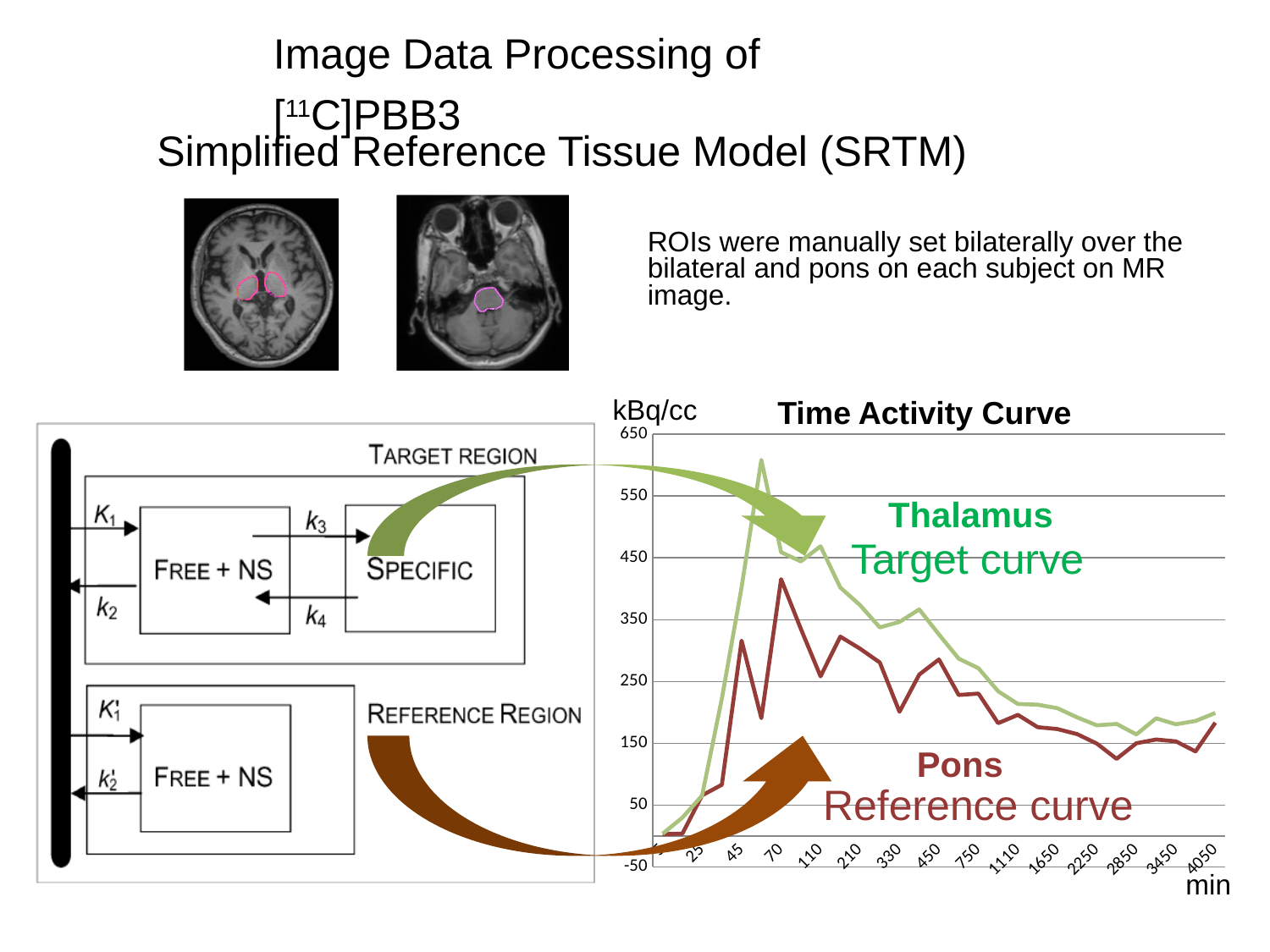
What kind of chart is the Time Activity Curve? line chart Is the peak value of the Pons curve greater or less than 450 kBq/cc? less Is the peak value of the Thalamus curve greater or less than 550 kBq/cc? greater How many curves are plotted on the Time Activity Curve chart? 2 Which curve reaches the higher peak value, Thalamus or Pons? Thalamus After reaching their peaks, do the Thalamus and Pons curves generally rise or fall along the x axis? fall What unit is shown on the y axis of the Time Activity Curve chart? kBq/cc Is the peak value of the Pons curve greater or less than 350 kBq/cc? greater What is the title of the chart on the slide? Time Activity Curve